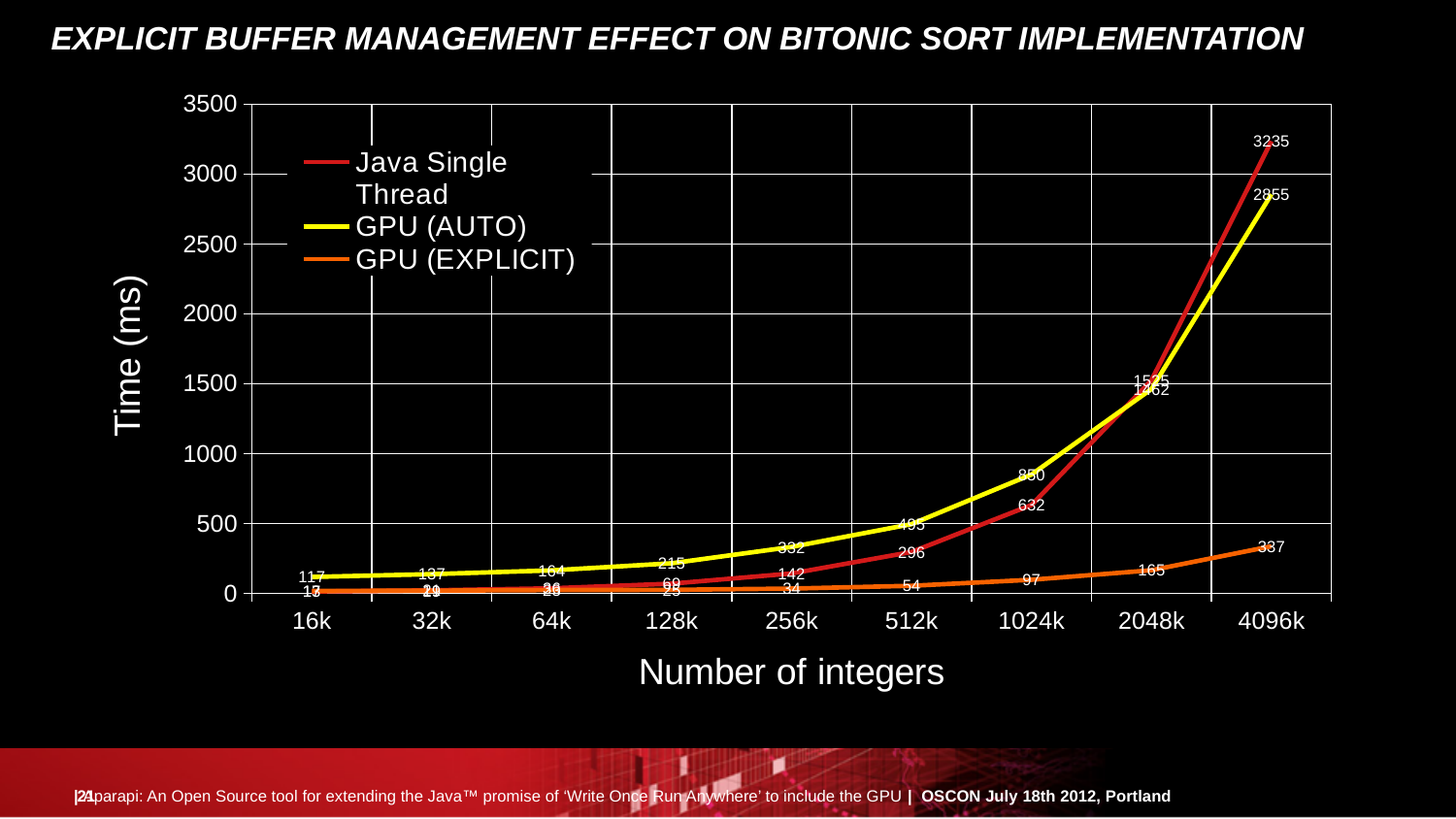
How many series does the legend list? 3 Which series has the highest value at 4096k integers? Java Single Thread What is the time for GPU (EXPLICIT) at 1024k integers? 97 What is the time for GPU (AUTO) at 4096k integers? 2855 What is the time for GPU (EXPLICIT) at 4096k integers? 337 What is the time for Java Single Thread at 4096k integers? 3235 What kind of chart is shown on the slide? line chart Does the Java Single Thread time rise or fall as the number of integers increases? rise What is the difference between Java Single Thread and GPU (AUTO) at 4096k integers? 380 How many points are plotted along the x axis (Number of integers)? 9 At 1024k integers, which is larger: GPU (AUTO) or Java Single Thread? GPU (AUTO) What is the time for GPU (AUTO) at 512k integers? 495